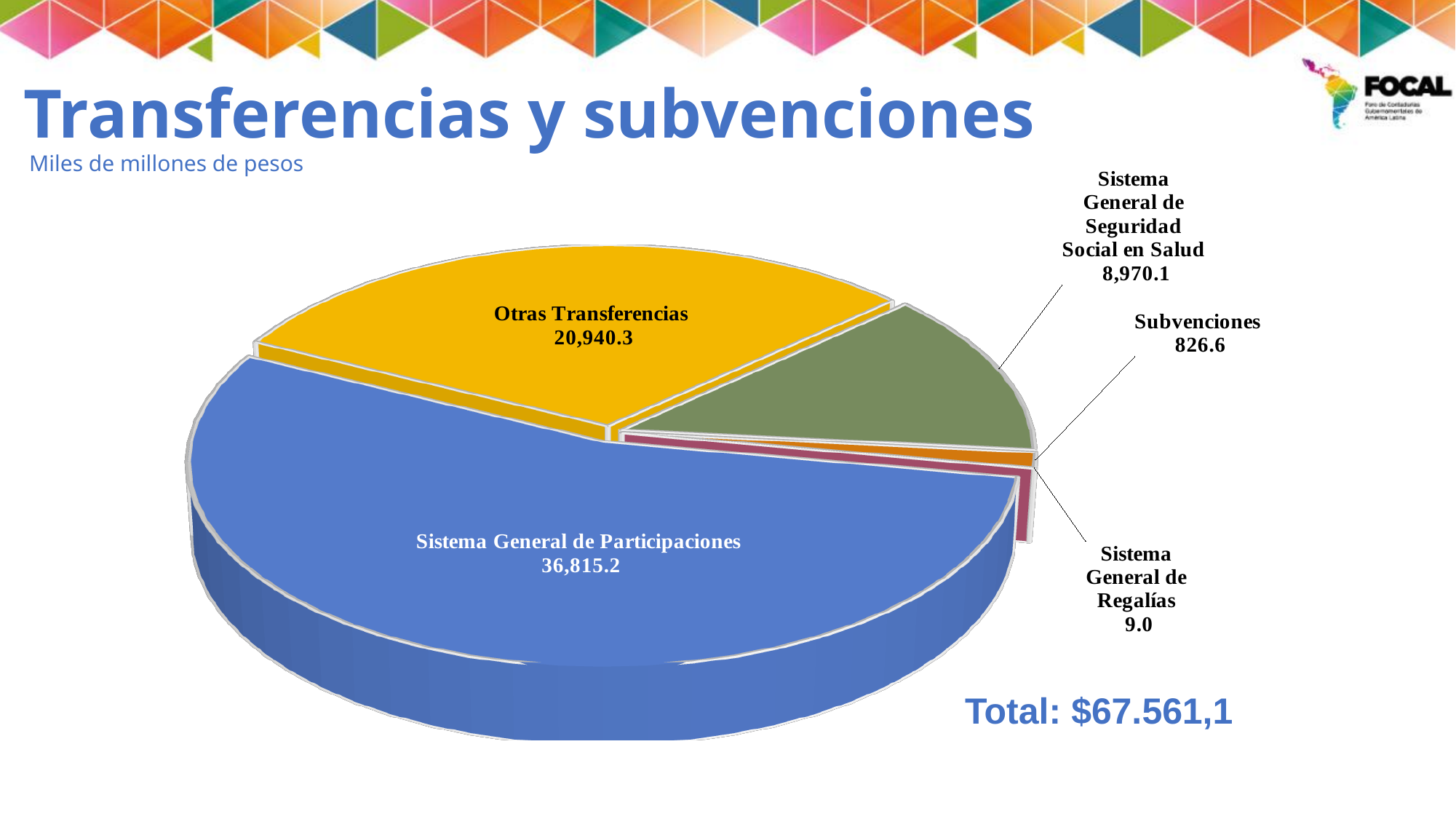
What is the value for Otras Transferencias? 20,940.3 What is the value for Sistema General de Seguridad Social en Salud? 8,970.1 What kind of chart is shown on the slide? Pie chart Which is larger, Sistema General de Seguridad Social en Salud or Subvenciones? Sistema General de Seguridad Social en Salud What is the value for Subvenciones? 826.6 What is the difference between Sistema General de Participaciones and Otras Transferencias? 15,874.9 What is the value for Sistema General de Participaciones? 36,815.2 Which category has the smallest slice of the pie? Sistema General de Regalías What is the value for Sistema General de Regalías? 9.0 How many slices does the pie chart have? 5 Which category has the largest slice of the pie? Sistema General de Participaciones What total is printed on the slide? $67.561,1